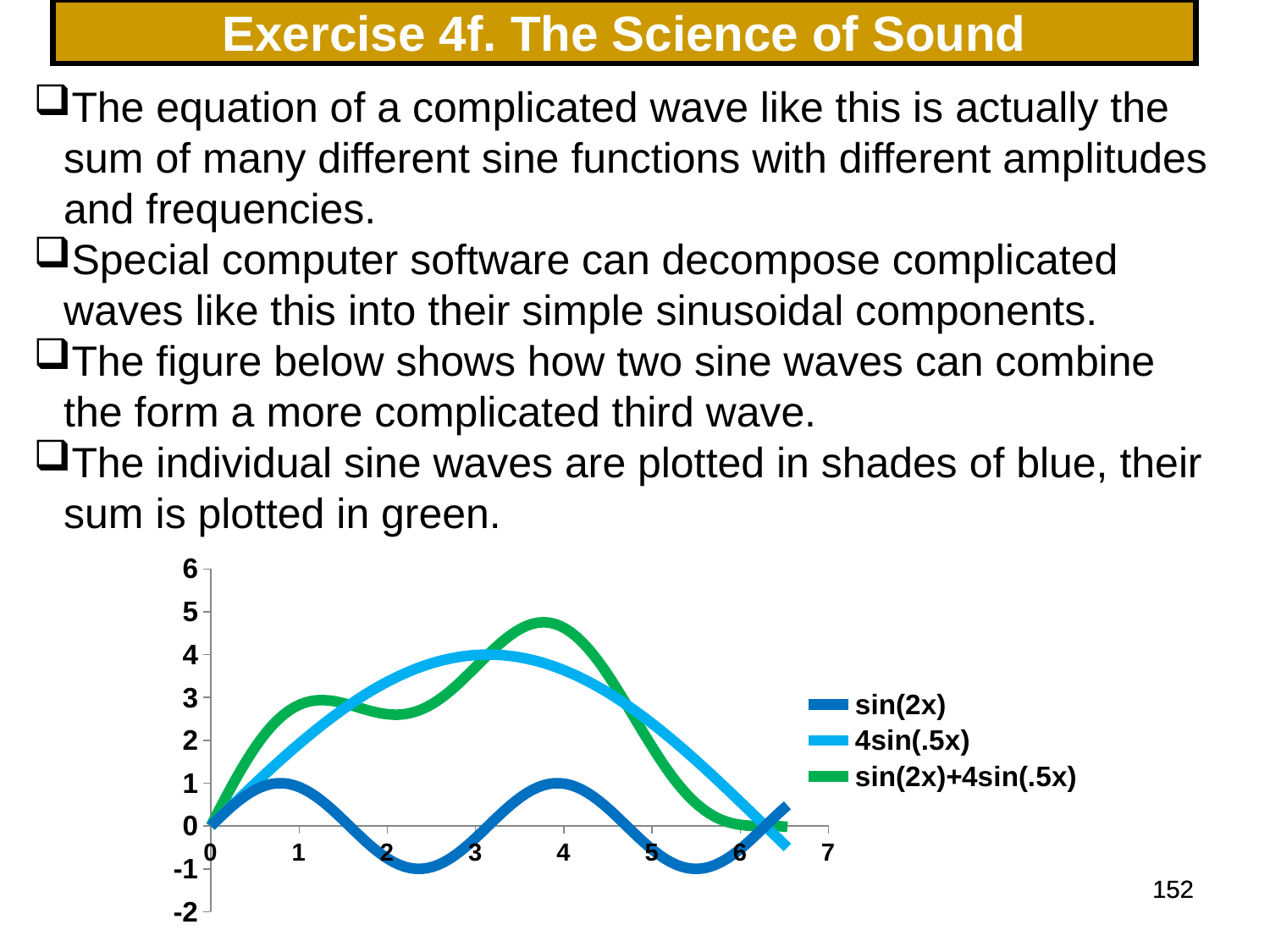
What value do all three series have at x = 0? 0 What kind of chart is shown on the slide? line chart Is the peak value of the sin(2x)+4sin(.5x) series greater or less than 4? greater Is the value of the sin(2x) series at x = 2 greater or less than 0? less Does the sin(2x)+4sin(.5x) series rise or fall between x = 4 and x = 6? fall Which series reaches the highest value on the chart? sin(2x)+4sin(.5x) What is the highest value shown on the chart's vertical axis? 6 Is the value of the 4sin(.5x) series at x = 3 greater or less than 3? greater At x = 1, which series has the larger value, sin(2x) or sin(2x)+4sin(.5x)? sin(2x)+4sin(.5x) How many series does the chart legend list? 3 Which series reaches the lowest value on the chart? sin(2x) Which series is plotted in green according to the legend? sin(2x)+4sin(.5x)